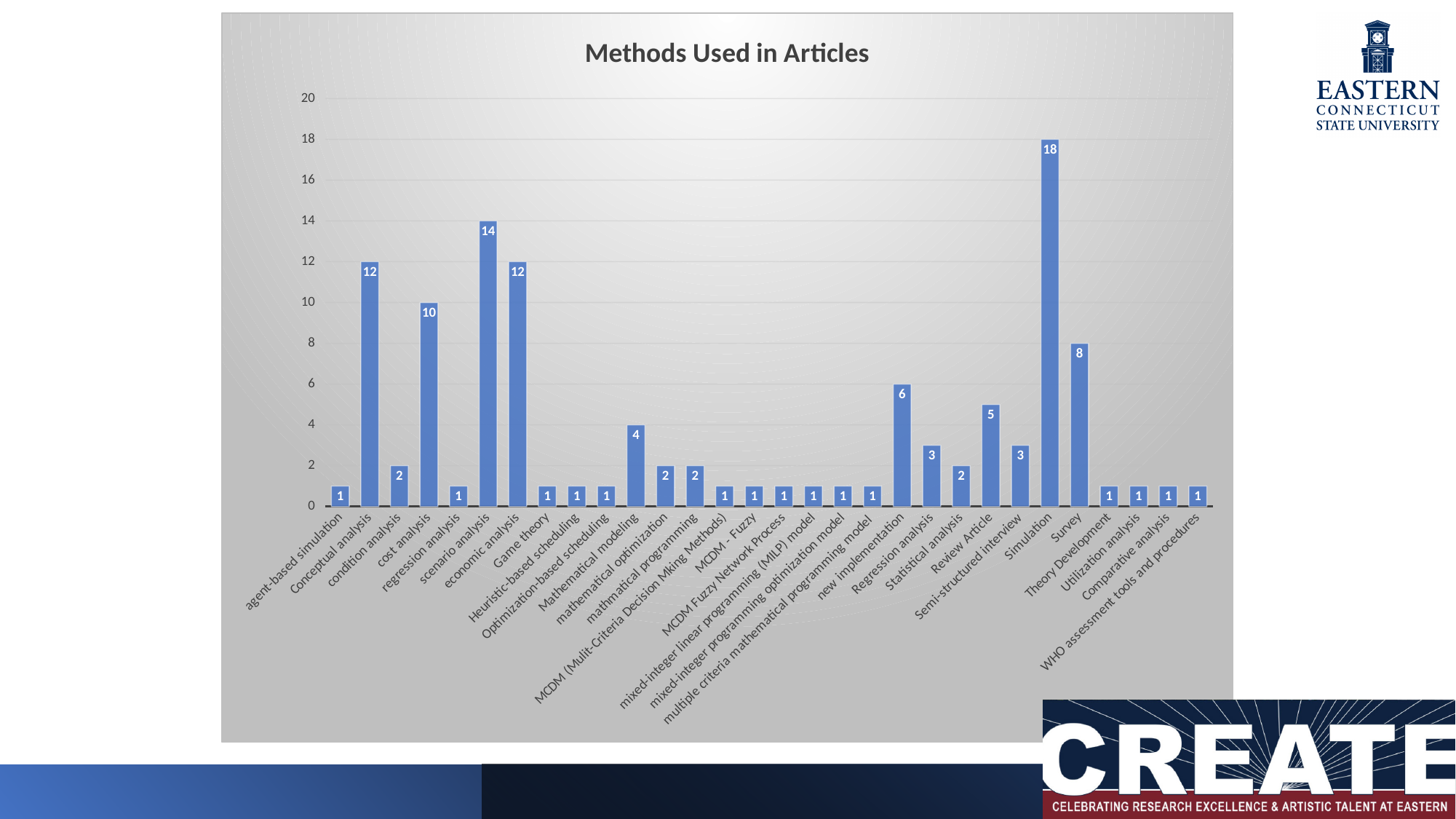
What is the title of the chart? Methods Used in Articles Which method has the highest value? Simulation Which is larger, the value for cost analysis or the value for Survey? cost analysis What kind of chart is shown on the slide? bar chart What is the value for scenario analysis? 14 What is the difference between the values for Conceptual analysis and cost analysis? 2 What is the value for Survey? 8 What is the value for Simulation? 18 What is the value for new implementation? 6 Which is larger, the value for Review Article or the value for Regression analysis? Review Article What is the difference between the values for Simulation and scenario analysis? 4 What is the value for Mathematical modeling? 4